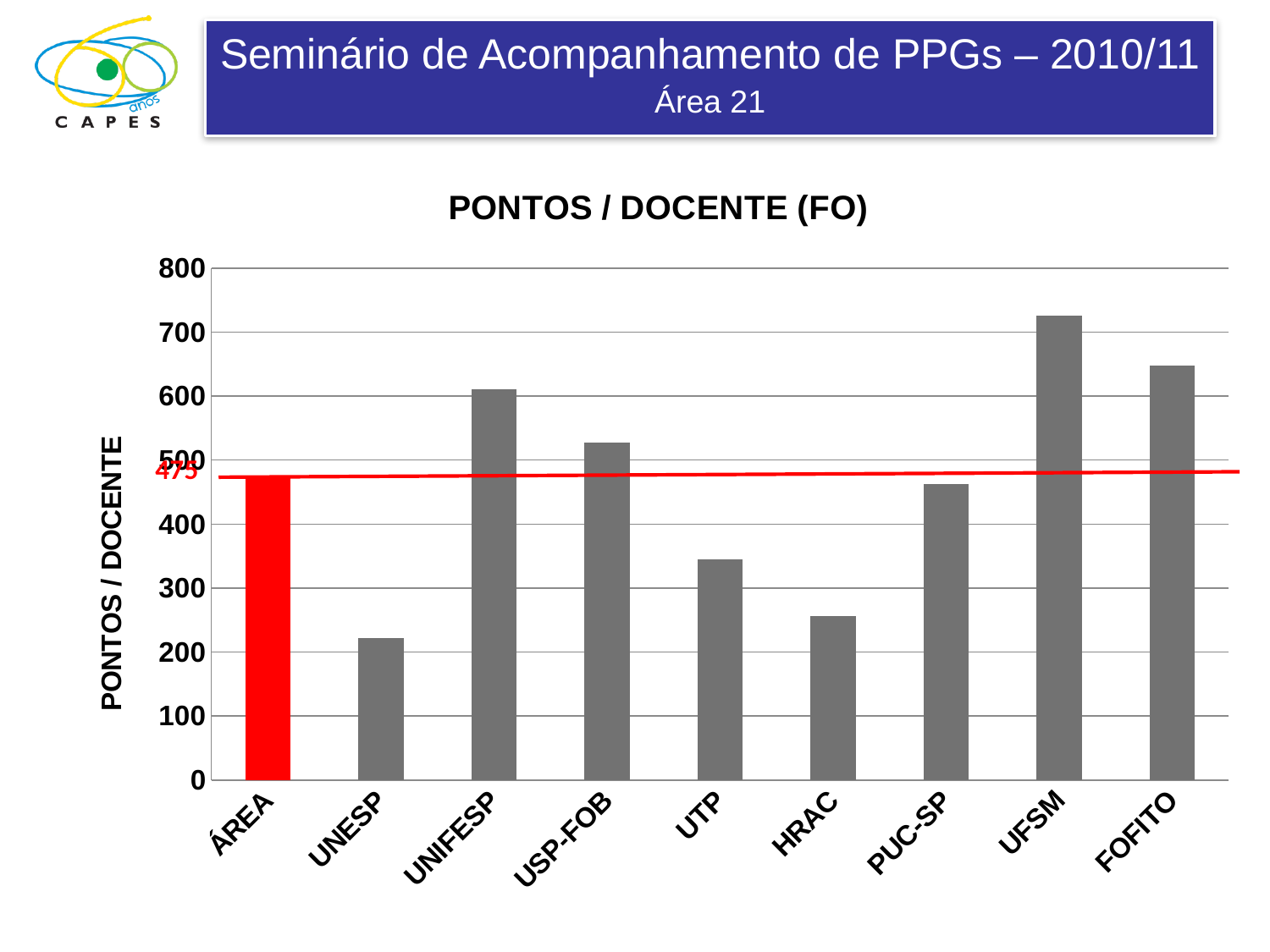
Is the value for UFSM greater or less than 700? greater Which category has the highest value in the PONTOS / DOCENTE (FO) chart? UFSM What is the title of the chart? PONTOS / DOCENTE (FO) What is the value printed for ÁREA in the PONTOS / DOCENTE (FO) chart? 475 Which category has the lowest value in the PONTOS / DOCENTE (FO) chart? UNESP What kind of chart is shown on the slide? Bar chart How many categories are shown on the x axis of the chart? 9 Is the value for UTP greater or less than 400? less Which has a larger value, UNIFESP or USP-FOB? UNIFESP Is the value for FOFITO greater or less than 600? greater Which has a larger value, UFSM or FOFITO? UFSM